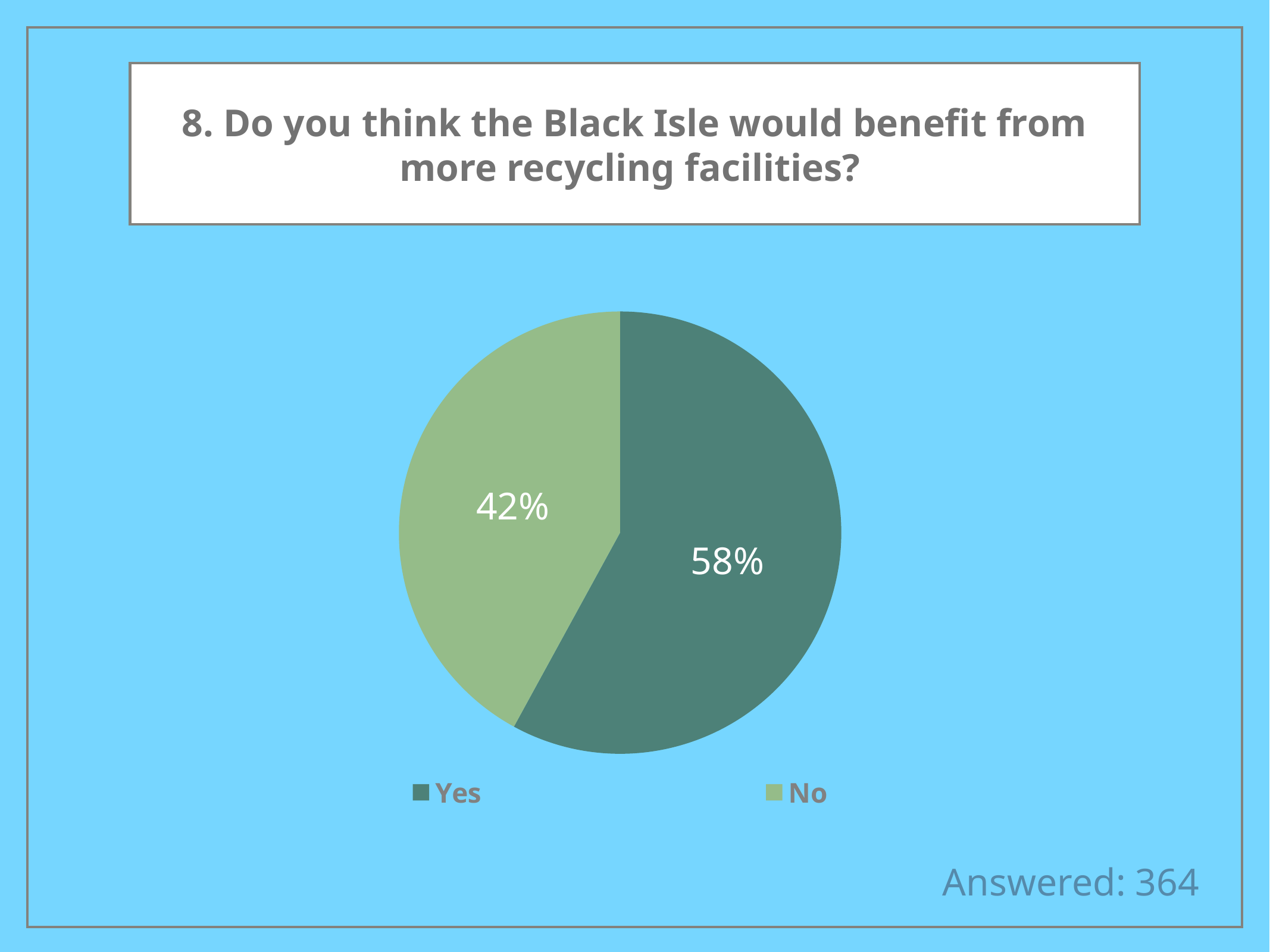
What type of chart is shown on the slide? Pie chart How many people answered this question, according to the slide? 364 Which response has the smallest share of the pie? No Which is larger, the share for Yes or the share for No? Yes What percentage of respondents answered Yes? 58% Which legend entry is shown in the darker green colour? Yes How many entries does the legend list? 2 What share of the pie does the No slice represent? 42% What percentage of respondents answered No? 42% Which response has the largest share of the pie? Yes How many slices does the pie chart have? 2 What is the difference in percentage points between the Yes and No shares? 16